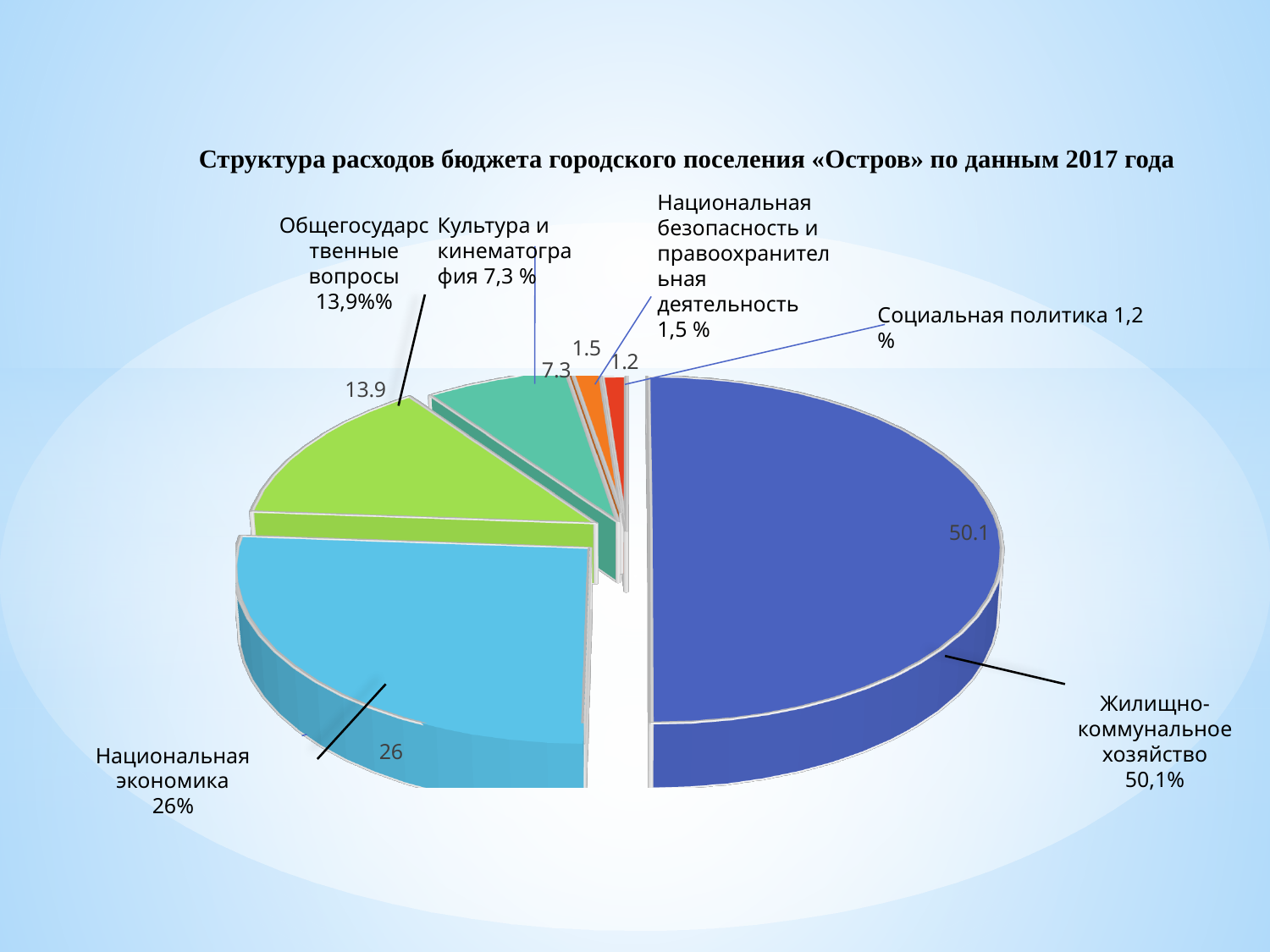
What is the difference between the values for Жилищно-коммунальное хозяйство and Национальная экономика? 24.1 What kind of chart is shown on the slide? pie chart Which year's data does the chart title say it is based on? 2017 What is the value shown for Общегосударственные вопросы? 13.9 What share of the pie does Жилищно-коммунальное хозяйство represent? 50.1% Which is larger: Общегосударственные вопросы or Культура и кинематография? Общегосударственные вопросы What is the value shown for Культура и кинематография? 7.3 How many slices does the pie chart have? 6 What is the value shown for Национальная безопасность и правоохранительная деятельность? 1.5 Which category has the smallest share of the budget expenditures? Социальная политика Which category has the largest share of the budget expenditures? Жилищно-коммунальное хозяйство What is the value shown for Национальная экономика? 26